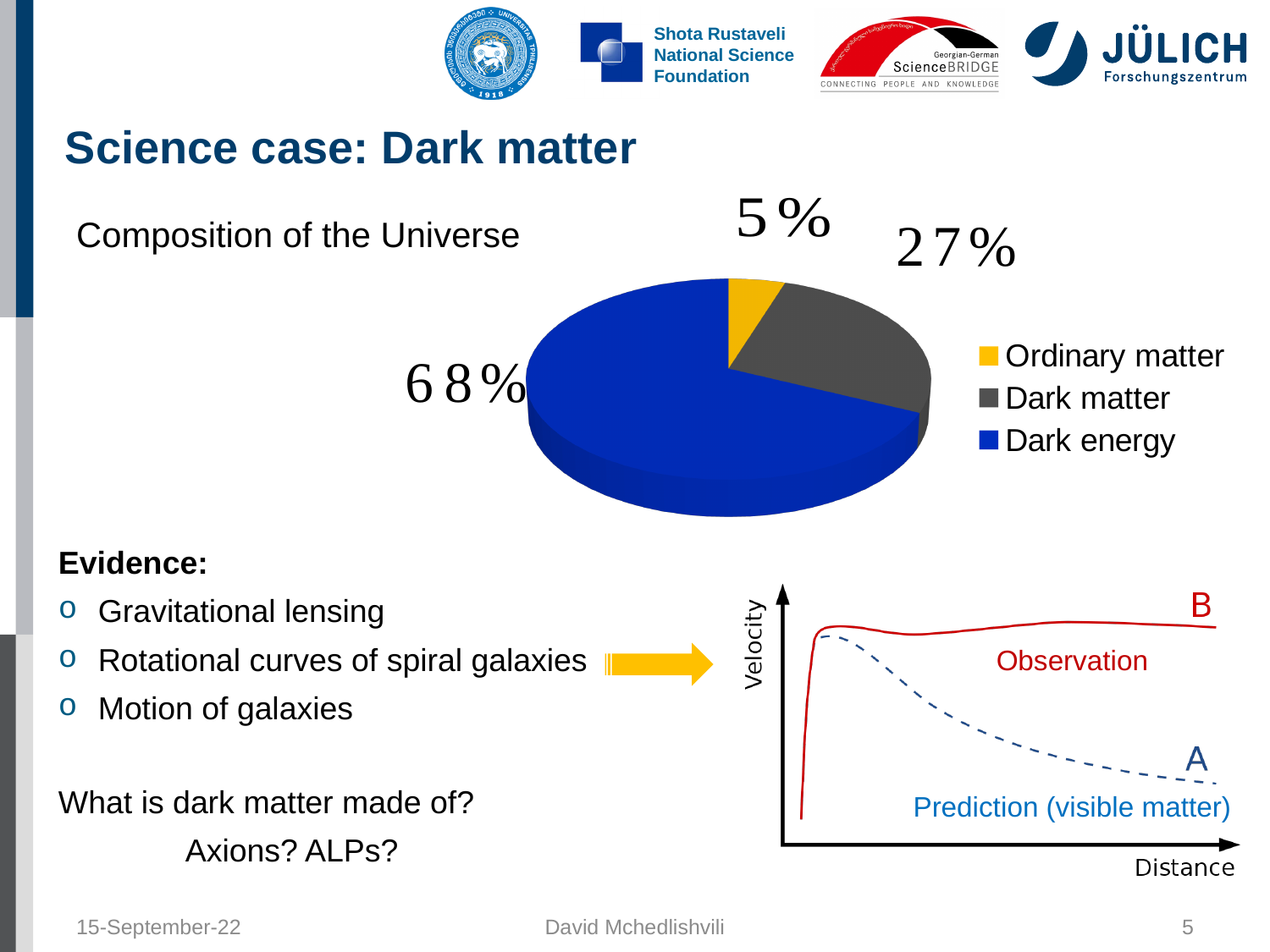
In the Composition of the Universe pie chart, what percentage is Dark matter? 27% In the Composition of the Universe pie chart, which component has the smallest share? Ordinary matter In the Velocity versus Distance graph at the bottom right, does the Prediction (visible matter) curve rise or fall as distance increases beyond its peak? Fall In the Composition of the Universe pie chart, which component has the largest share? Dark energy In the Composition of the Universe pie chart, what is the combined share of Dark matter and Ordinary matter? 32% What kind of chart is used to show the Composition of the Universe? Pie chart In the Composition of the Universe pie chart, what percentage is Ordinary matter? 5% In the Composition of the Universe pie chart, how many percentage points larger is Dark energy than Dark matter? 41% In the Composition of the Universe pie chart, what colour represents Dark energy in the legend? Blue In the Composition of the Universe pie chart, which is larger: Dark matter or Ordinary matter? Dark matter In the Composition of the Universe pie chart, what percentage is Dark energy? 68% How many slices does the Composition of the Universe pie chart have? 3